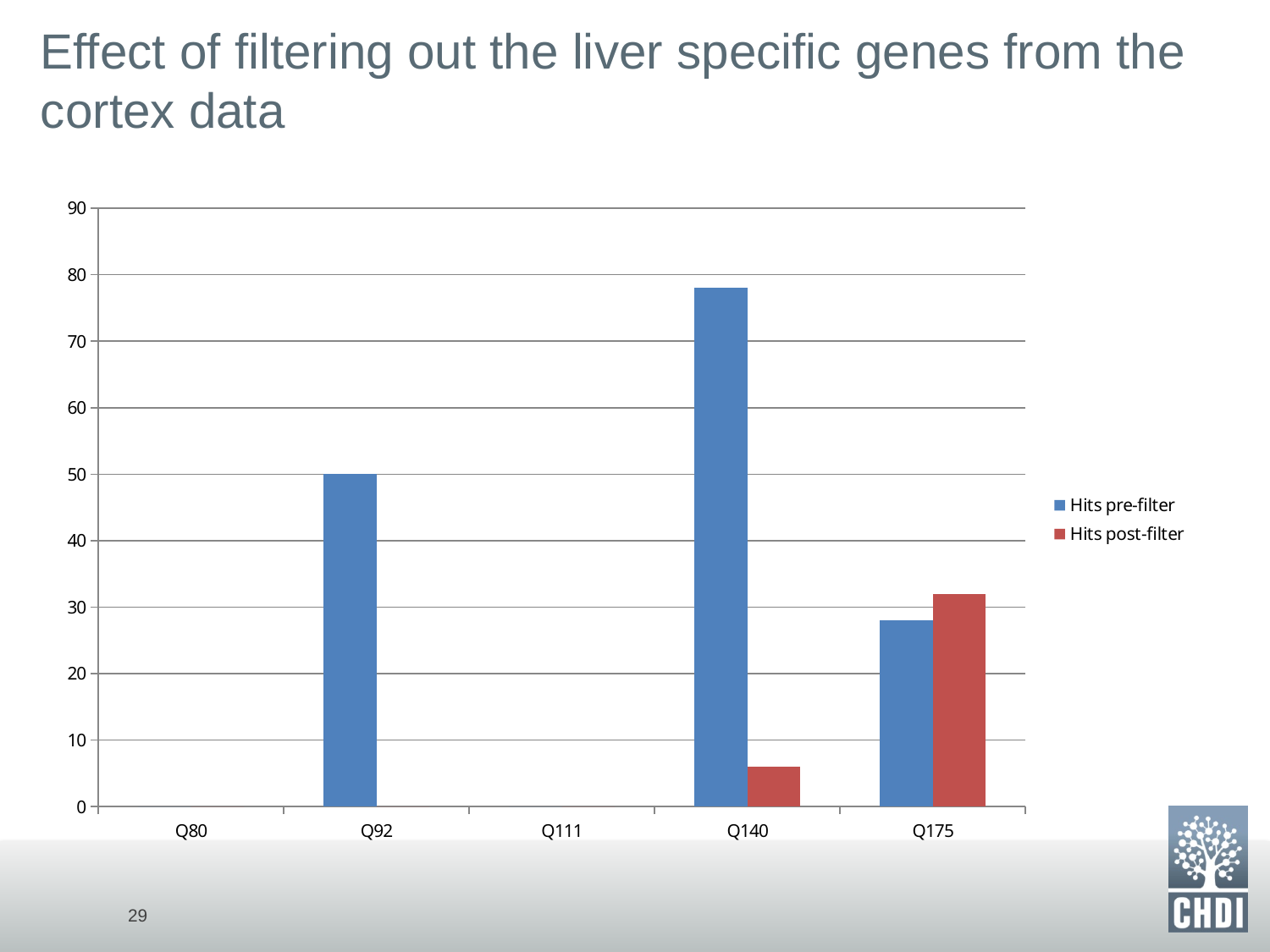
How many series does the legend list? 2 Is the value for Hits post-filter at Q140 greater or less than 10? less What colour represents Hits post-filter in the legend? red What kind of chart is shown on the slide? bar chart Is the value for Hits post-filter at Q175 greater or less than 20? greater Which category has the highest value for Hits pre-filter? Q140 What is the value for Hits pre-filter at Q92? 50 At Q175, which is larger: Hits pre-filter or Hits post-filter? Hits post-filter Which category has the highest value for Hits post-filter? Q175 Is the value for Hits pre-filter at Q140 greater or less than 70? greater How many categories are shown on the x axis? 5 Which is larger: Hits pre-filter at Q92 or Hits pre-filter at Q140? Hits pre-filter at Q140